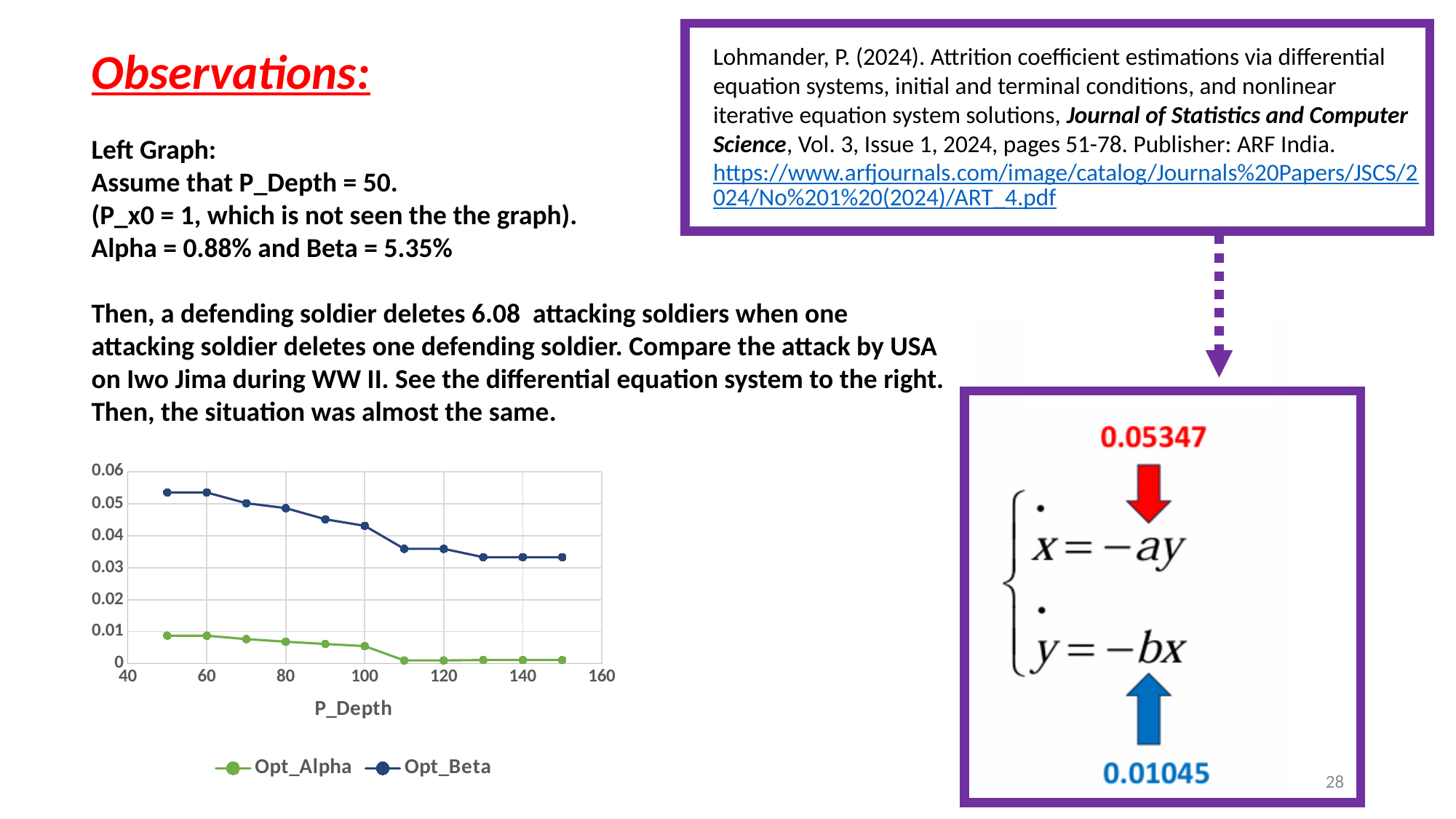
What kind of chart is shown on the slide? line chart Which colour is used for the Opt_Alpha series in the chart? green Do the Opt_Alpha values rise or fall as P_Depth increases? fall Is the Opt_Alpha value at P_Depth = 50 greater or less than 0.01? less Is the Opt_Beta value at P_Depth = 50 greater or less than 0.05? greater Is the Opt_Beta value at P_Depth = 110 greater or less than 0.04? less At P_Depth = 100, which series has the larger value, Opt_Alpha or Opt_Beta? Opt_Beta What is the title of the x axis of the chart? P_Depth Do the Opt_Beta values rise or fall as P_Depth increases? fall How many data points are plotted for the Opt_Beta series? 11 How many series does the chart legend list? 2